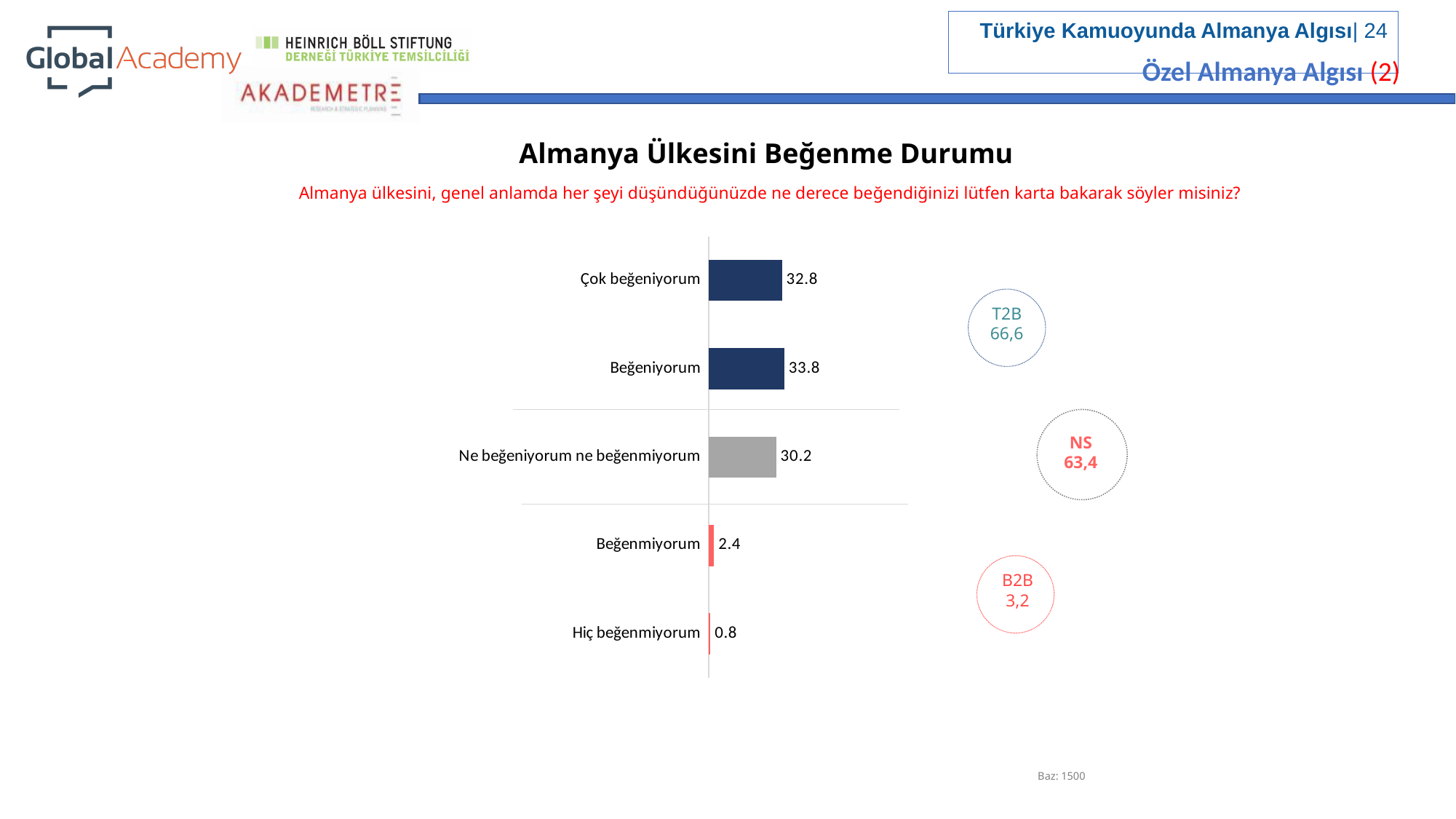
What kind of chart is shown on the slide? Bar chart What is the difference between the values for "Beğeniyorum" and "Çok beğeniyorum"? 1.0 How many categories are shown in the chart? 5 What is the value for "Hiç beğenmiyorum"? 0.8 Which is larger, the value for "Ne beğeniyorum ne beğenmiyorum" or the value for "Beğenmiyorum"? Ne beğeniyorum ne beğenmiyorum What is the value for "Çok beğeniyorum"? 32.8 What is the difference between the values for "Beğenmiyorum" and "Hiç beğenmiyorum"? 1.6 Which category has the highest value? Beğeniyorum What is the value for "Beğeniyorum"? 33.8 What is the T2B value shown in the circle next to the chart? 66,6 What is the value for "Ne beğeniyorum ne beğenmiyorum"? 30.2 Which category has the lowest value? Hiç beğenmiyorum